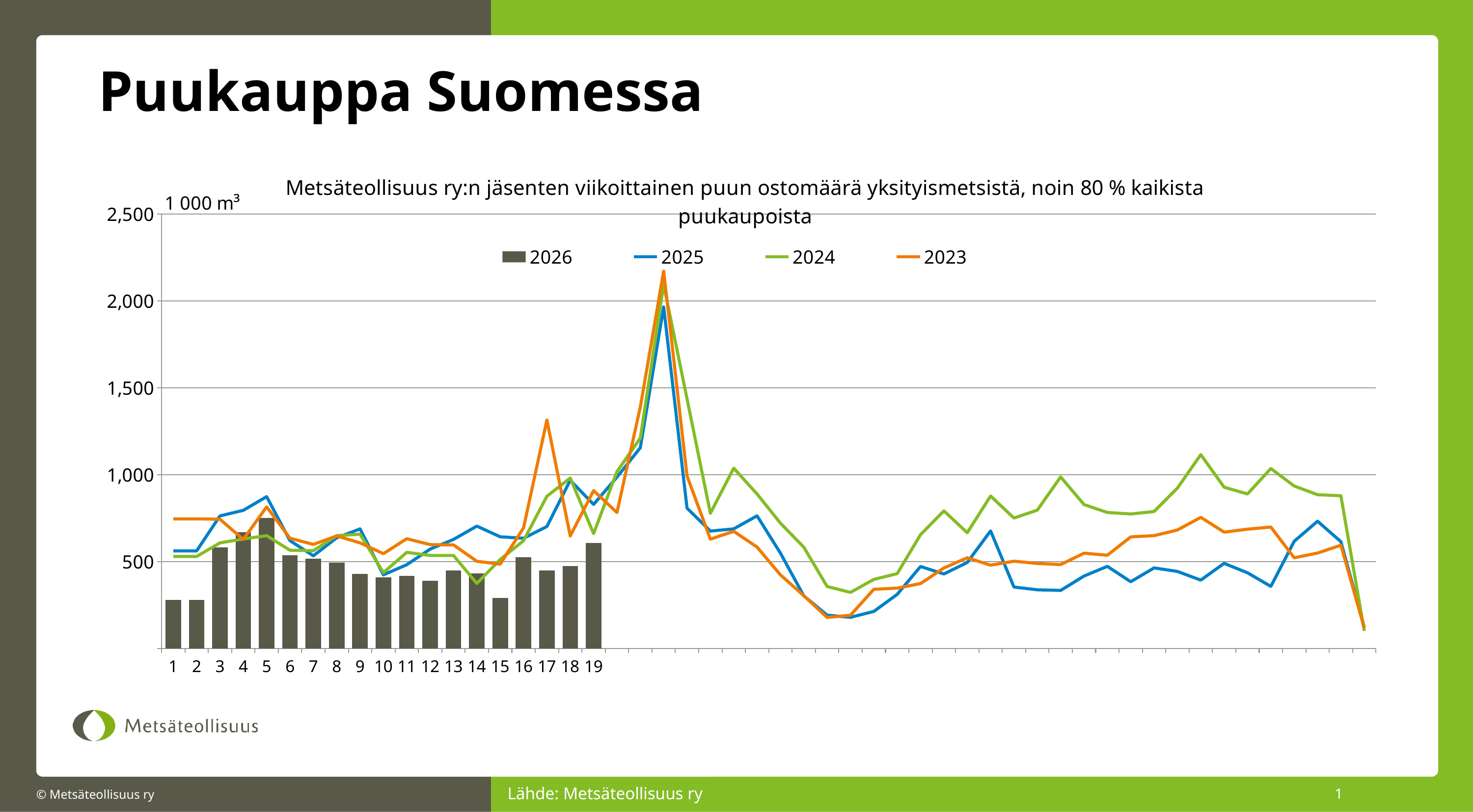
Is the 2026 value for week 5 greater or less than 500? greater Is the 2026 value for week 19 greater or less than 500? greater Do the 2026 bars rise or fall from week 1 to week 5? Rise Is the peak value of the 2023 line greater or less than 2,000? greater What unit is shown on the vertical axis? 1 000 m³ Which series reaches the highest value on the chart? 2023 What kind of chart is this? Combined bar and line chart Which week has the highest 2026 bar? 5 Which is larger, the 2026 value for week 5 or the 2026 value for week 15? Week 5 How many series does the legend list? 4 How many bars are plotted for the 2026 series? 19